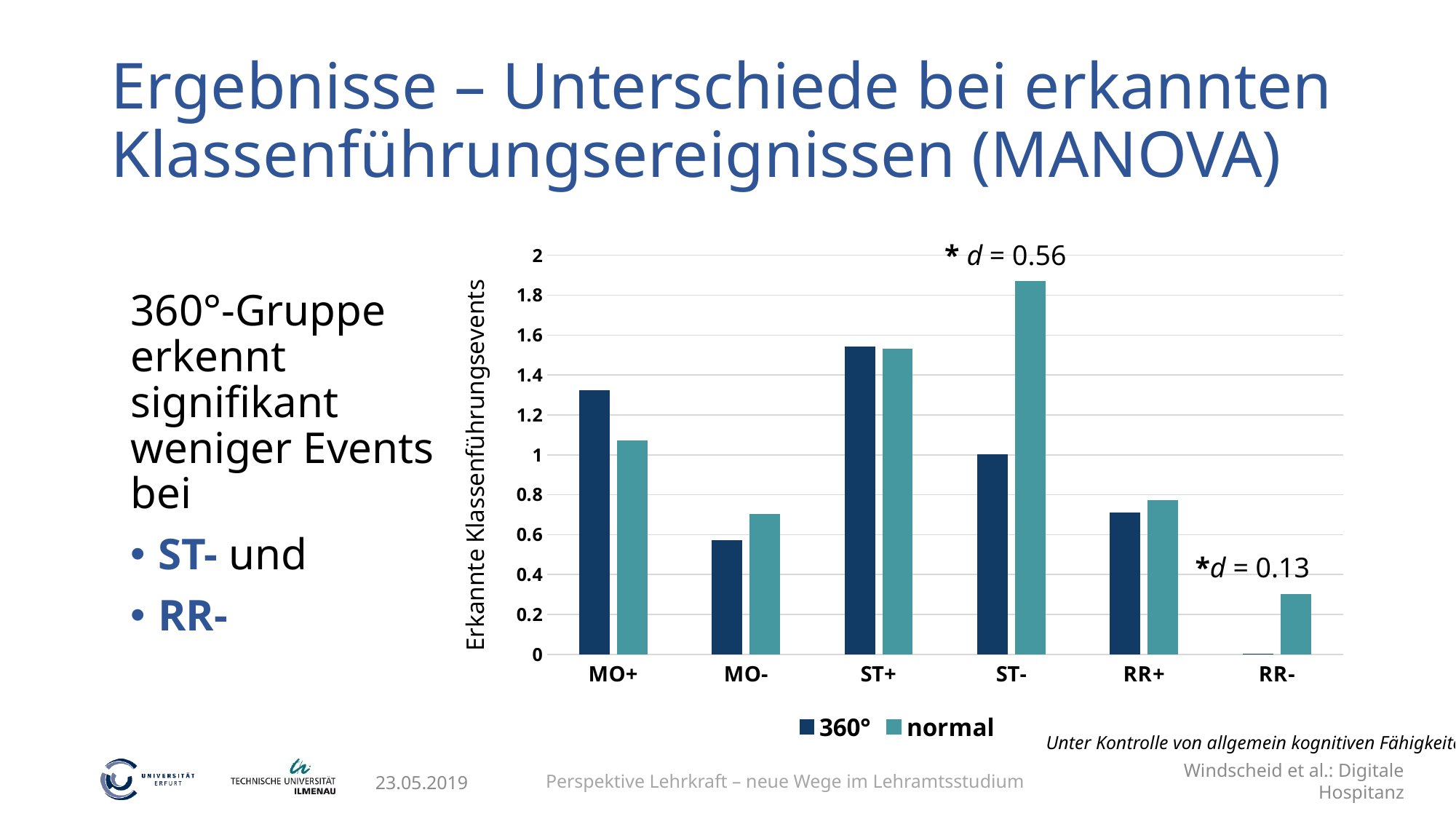
Is the value for the 360° series at MO+ greater or less than 1.2? greater Which category has the lowest value for the 360° series? RR- For MO+, which series has the larger value, 360° or normal? 360° How many series does the chart legend list? 2 What kind of chart is shown on the slide? bar chart For ST-, which series has the larger value, 360° or normal? normal What are the two entries in the chart legend? 360° and normal How many categories are shown on the x axis of the chart? 6 Which category has the highest value for the normal series? ST- Which category has the lowest value for the normal series? RR- Which category has the highest value for the 360° series? ST+ Is the value for the normal series at ST- greater or less than 1.6? greater